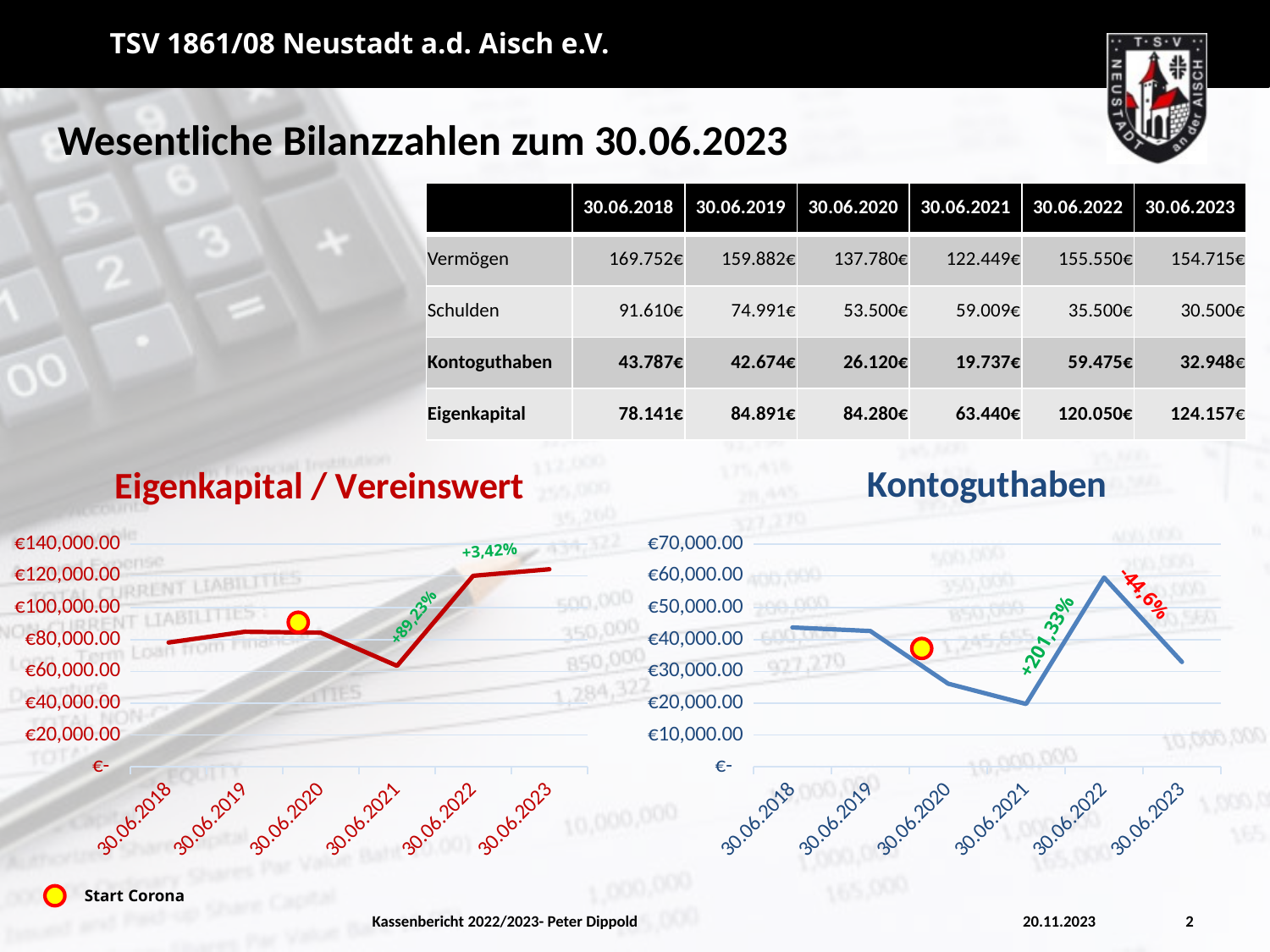
On the "Kontoguthaben" chart, what percentage change is labelled between 30.06.2022 and 30.06.2023? -44,6% On the "Kontoguthaben" chart, which date has the highest value? 30.06.2022 What does the yellow circle marker on the charts indicate, according to the legend at the bottom of the slide? Start Corona On the "Eigenkapital / Vereinswert" chart, what percentage change is labelled between 30.06.2021 and 30.06.2022? +89,23% What kind of chart is the "Eigenkapital / Vereinswert" chart? line chart On the "Kontoguthaben" chart, does the value rise or fall from 30.06.2022 to 30.06.2023? fall On the "Eigenkapital / Vereinswert" chart, which date has the lowest value? 30.06.2021 On the "Kontoguthaben" chart, which is larger: the value for 30.06.2018 or the value for 30.06.2021? 30.06.2018 On the "Kontoguthaben" chart, which date has the lowest value? 30.06.2021 On the "Eigenkapital / Vereinswert" chart, is the value for 30.06.2021 greater or less than €80,000.00? less How many data points are plotted on the "Kontoguthaben" chart? 6 On the "Kontoguthaben" chart, is the value for 30.06.2022 greater or less than €50,000.00? greater